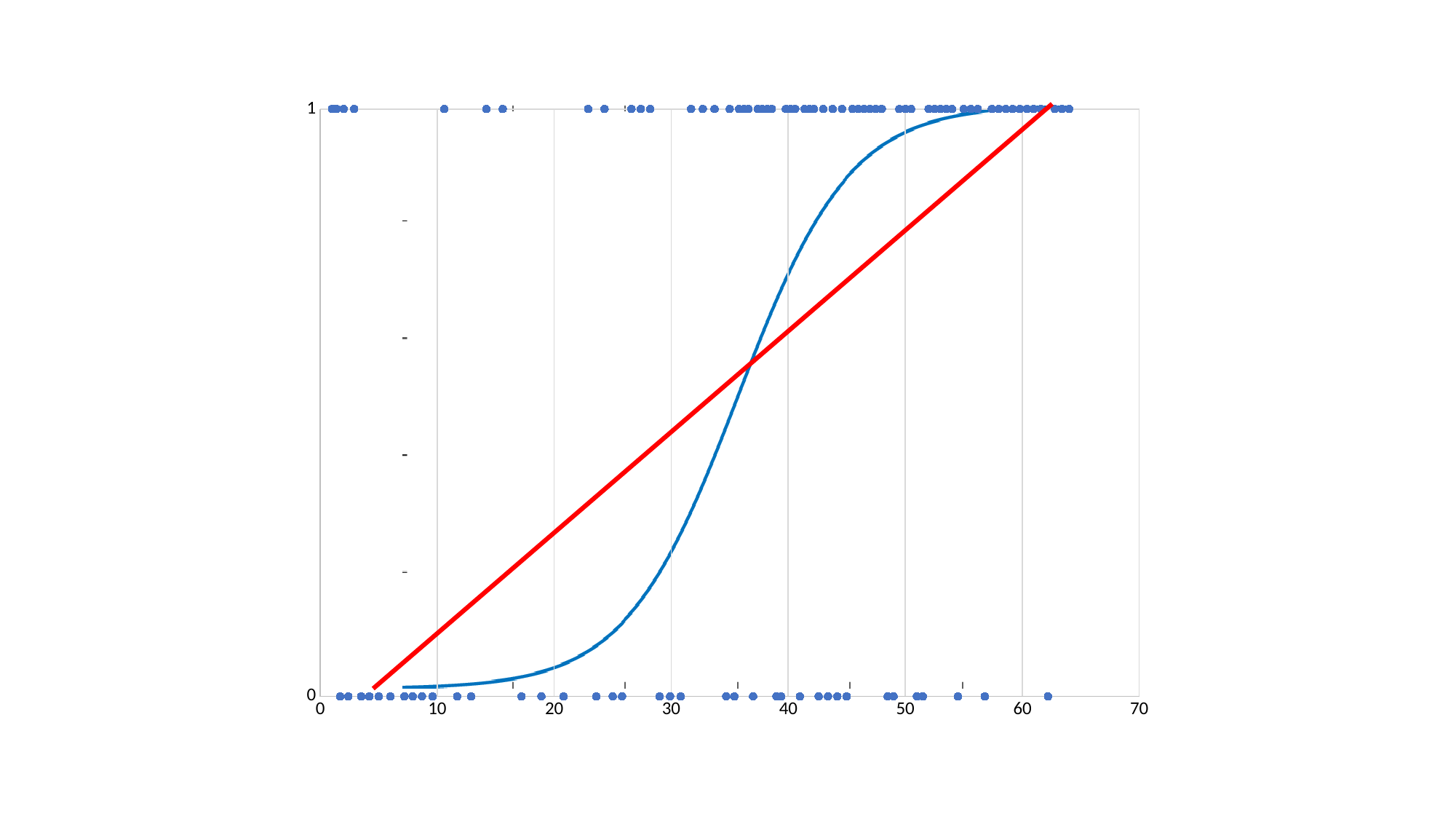
Does the blue S-shaped curve rise or fall as the x-axis value increases? rise At x = 30, which is higher, the red straight line or the blue S-shaped curve? the red straight line Does the red straight line rise or fall as the x-axis value increases? rise What is the largest value labelled on the x axis? 70 At x = 50, which is higher, the red straight line or the blue S-shaped curve? the blue S-shaped curve What colour is the straight line on the chart? red What kind of chart is shown on the slide? scatter chart At x = 20, which is higher, the red straight line or the blue S-shaped curve? the red straight line